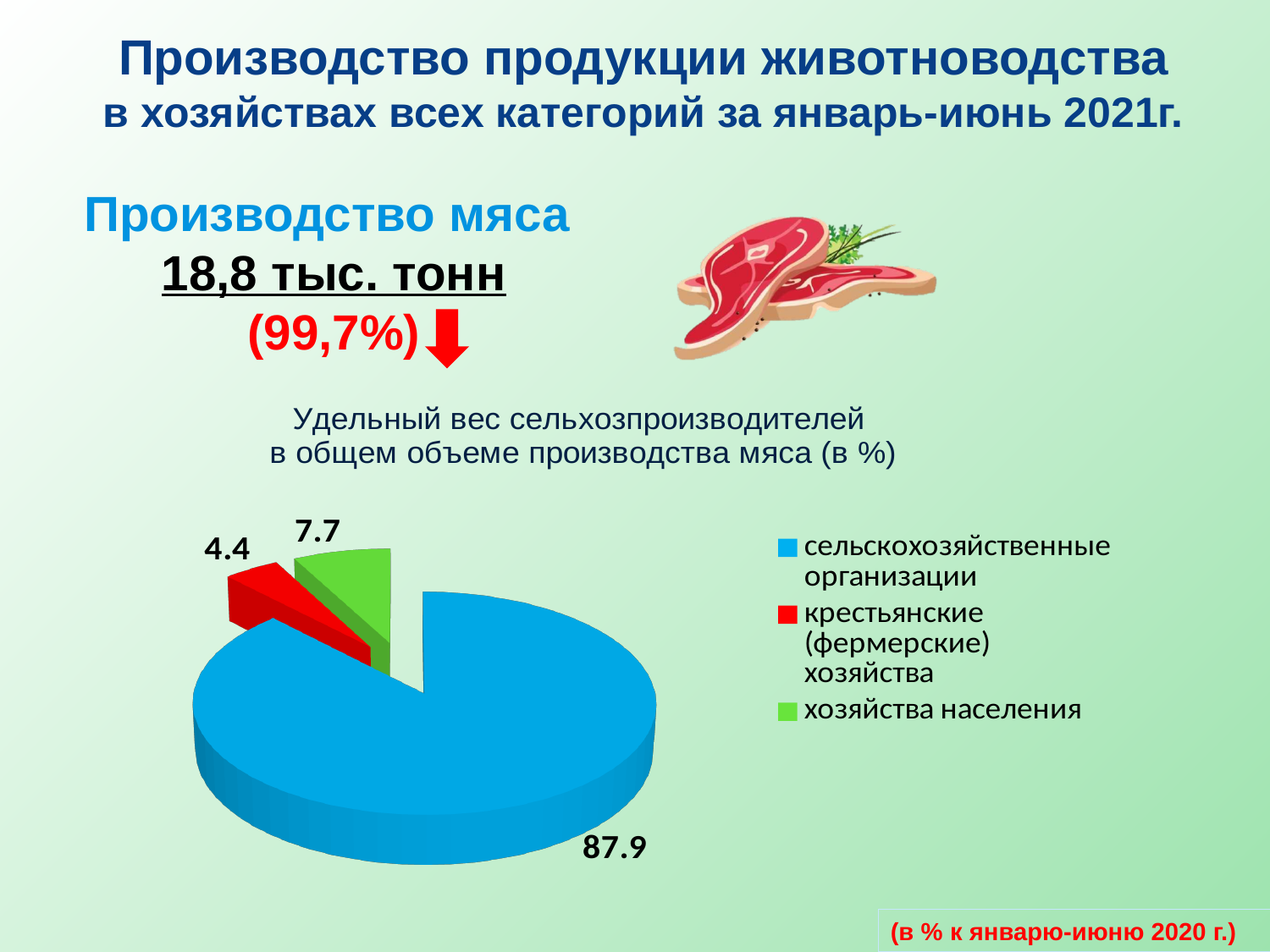
Which category has the smallest slice in the pie chart? крестьянские (фермерские) хозяйства What colour is the slice for хозяйства населения? green Which is larger: the share of хозяйства населения or the share of крестьянские (фермерские) хозяйства? хозяйства населения Which category has the largest slice in the pie chart? сельскохозяйственные организации What type of chart is shown on the slide? pie chart What is the share of крестьянские (фермерские) хозяйства in the pie chart? 4.4 What colour is the slice for сельскохозяйственные организации? blue How many slices does the pie chart have? 3 What is the share of сельскохозяйственные организации in the pie chart? 87.9 What is the share of хозяйства населения in the pie chart? 7.7 What is the difference between the shares of хозяйства населения and крестьянские (фермерские) хозяйства? 3.3 How many entries does the legend of the pie chart list? 3